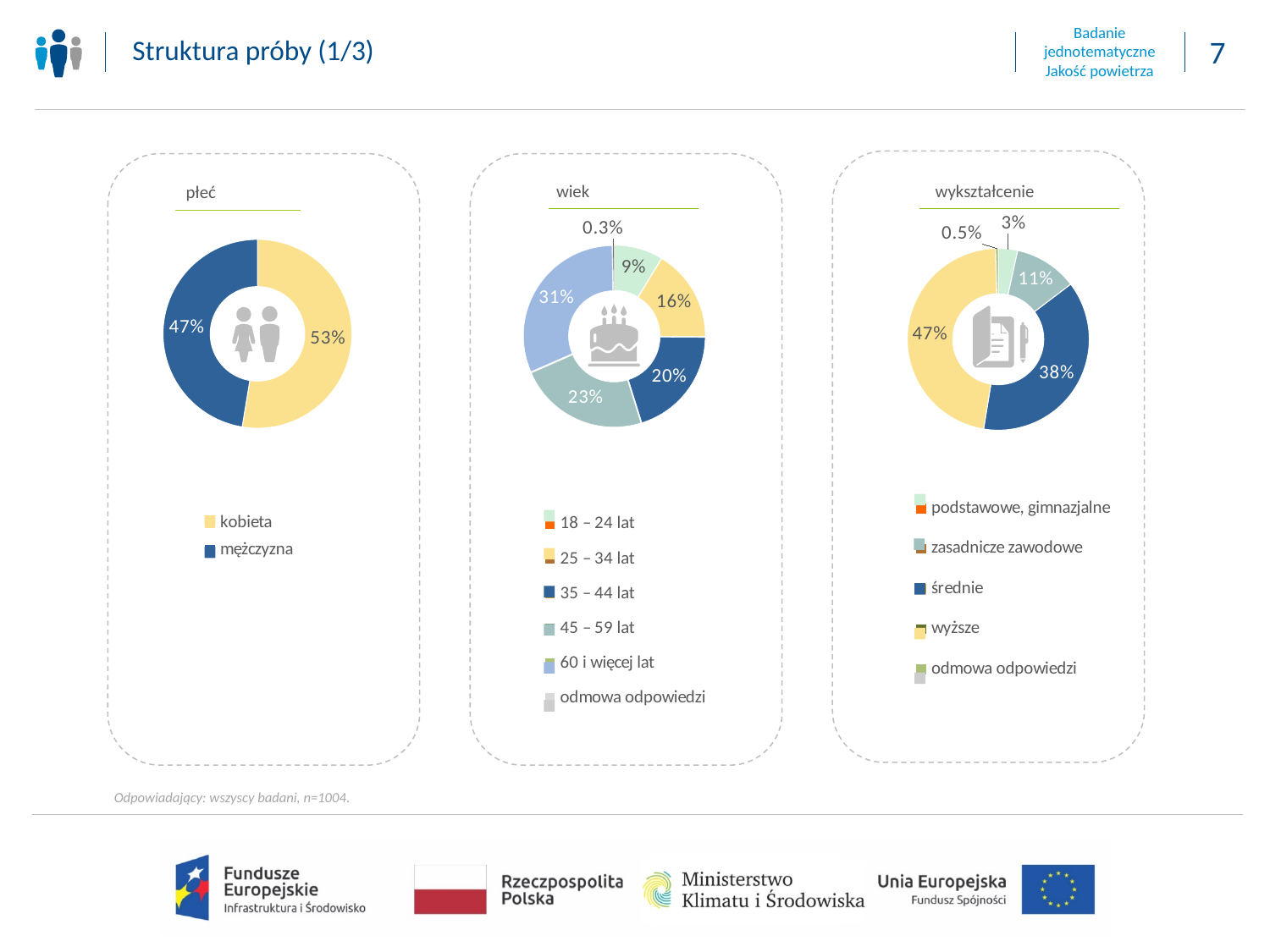
In the 'płeć' chart, what share is labelled for mężczyzna? 47% In the 'wykształcenie' chart, what share is labelled for średnie? 38% How many categories does the legend of the 'wiek' chart list? 6 In the 'wykształcenie' chart, which category has the largest share? wyższe In the 'wiek' chart, which age category has the smallest share? odmowa odpowiedzi In the 'wykształcenie' chart, what is the difference in percentage points between wyższe and średnie? 9 percentage points In the 'płeć' chart, which category has the larger share, kobieta or mężczyzna? kobieta In the 'wiek' chart, what share is labelled for 60 i więcej lat? 31% What type of chart is used for the 'płeć' chart? Donut (pie) chart In the 'płeć' chart, what share is labelled for kobieta? 53% In the 'wiek' chart, what share is labelled for 35 – 44 lat? 20% In the 'płeć' chart, what is the difference in percentage points between kobieta and mężczyzna? 6 percentage points